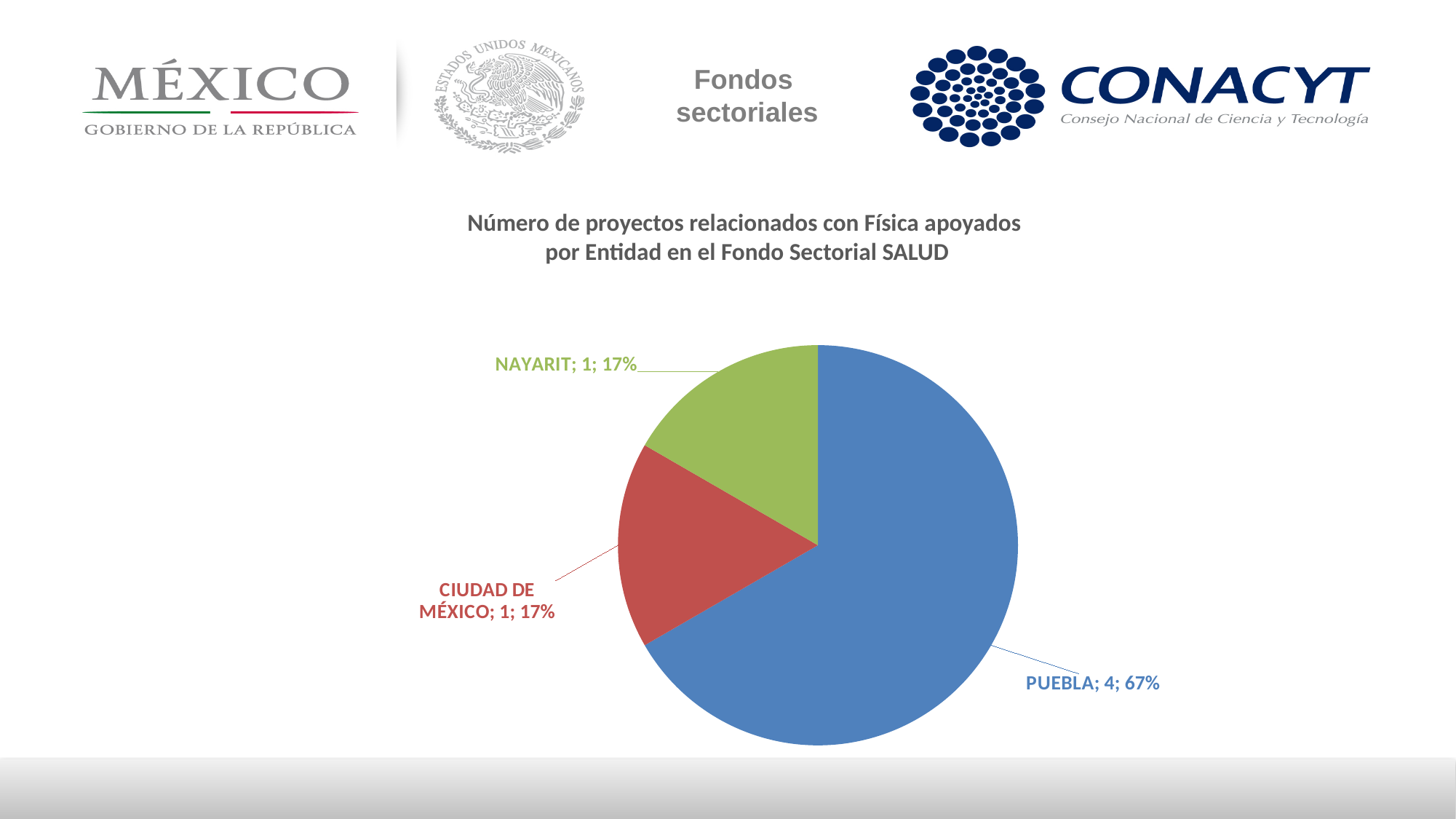
What share of the pie does PUEBLA account for? 67% How many entities (slices) are shown in the pie chart? 3 What is the total number of projects shown across all slices of the pie? 6 What is the difference in number of projects between PUEBLA and CIUDAD DE MÉXICO? 3 How many projects does the chart show for NAYARIT? 1 Which entity has the largest slice of the pie? PUEBLA What colour is the slice for CIUDAD DE MÉXICO? Red What kind of chart is shown on the slide? Pie chart What share of the pie does NAYARIT account for? 17% How many projects does the chart show for PUEBLA? 4 How many projects does the chart show for CIUDAD DE MÉXICO? 1 Which has more projects, PUEBLA or NAYARIT? PUEBLA